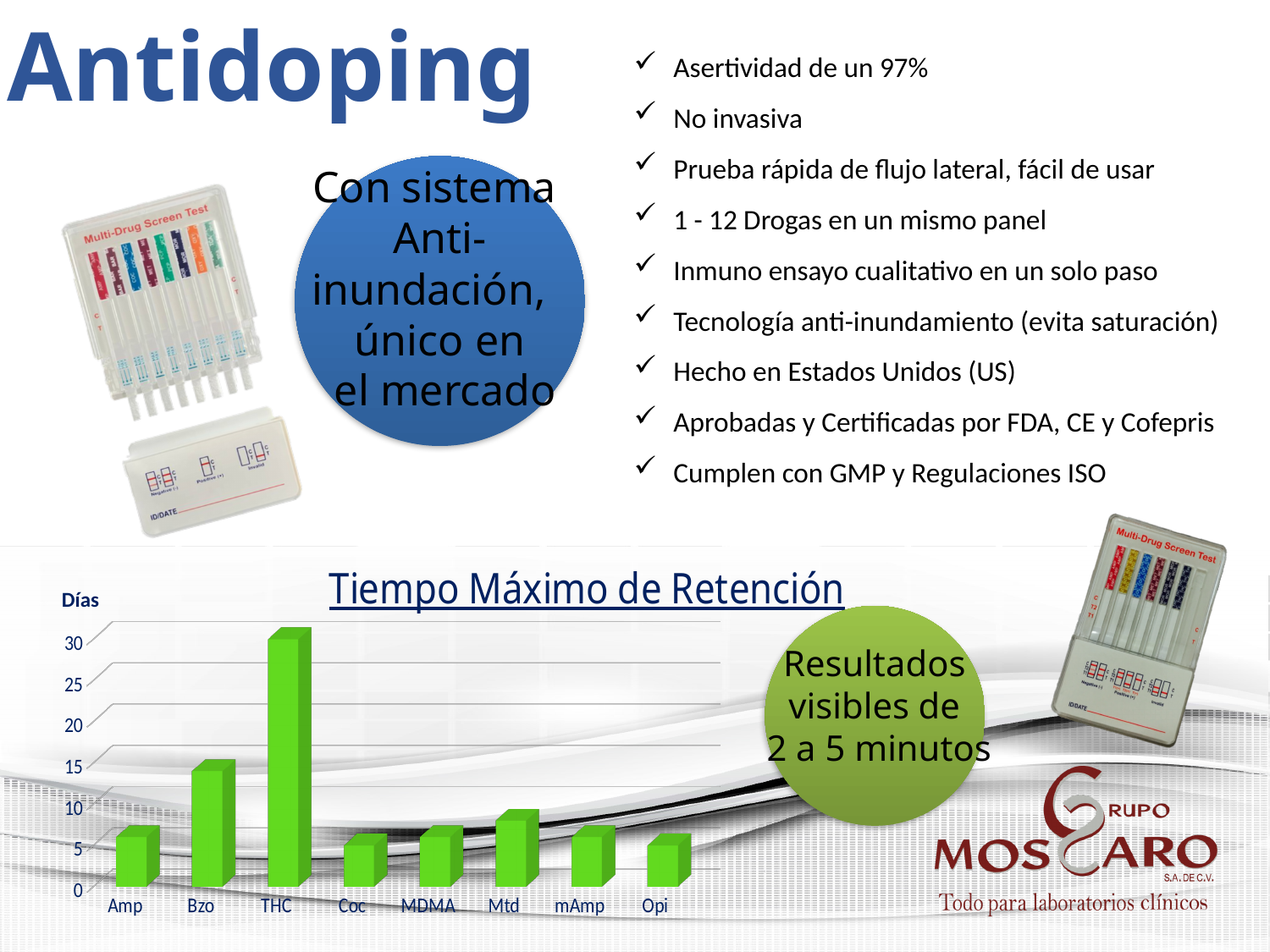
Which category has the highest value in the chart? THC Is the value for THC greater or less than 25? greater Is the value for Bzo greater or less than 20? less Is the value for Amp greater or less than 10? less What is the title of the chart? Tiempo Máximo de Retención Which has a larger value, THC or Bzo? THC How many categories are plotted in the chart? 8 What unit label is shown on the vertical axis of the chart? Días What type of chart is shown on the slide? bar chart Which has a larger value, Bzo or Mtd? Bzo